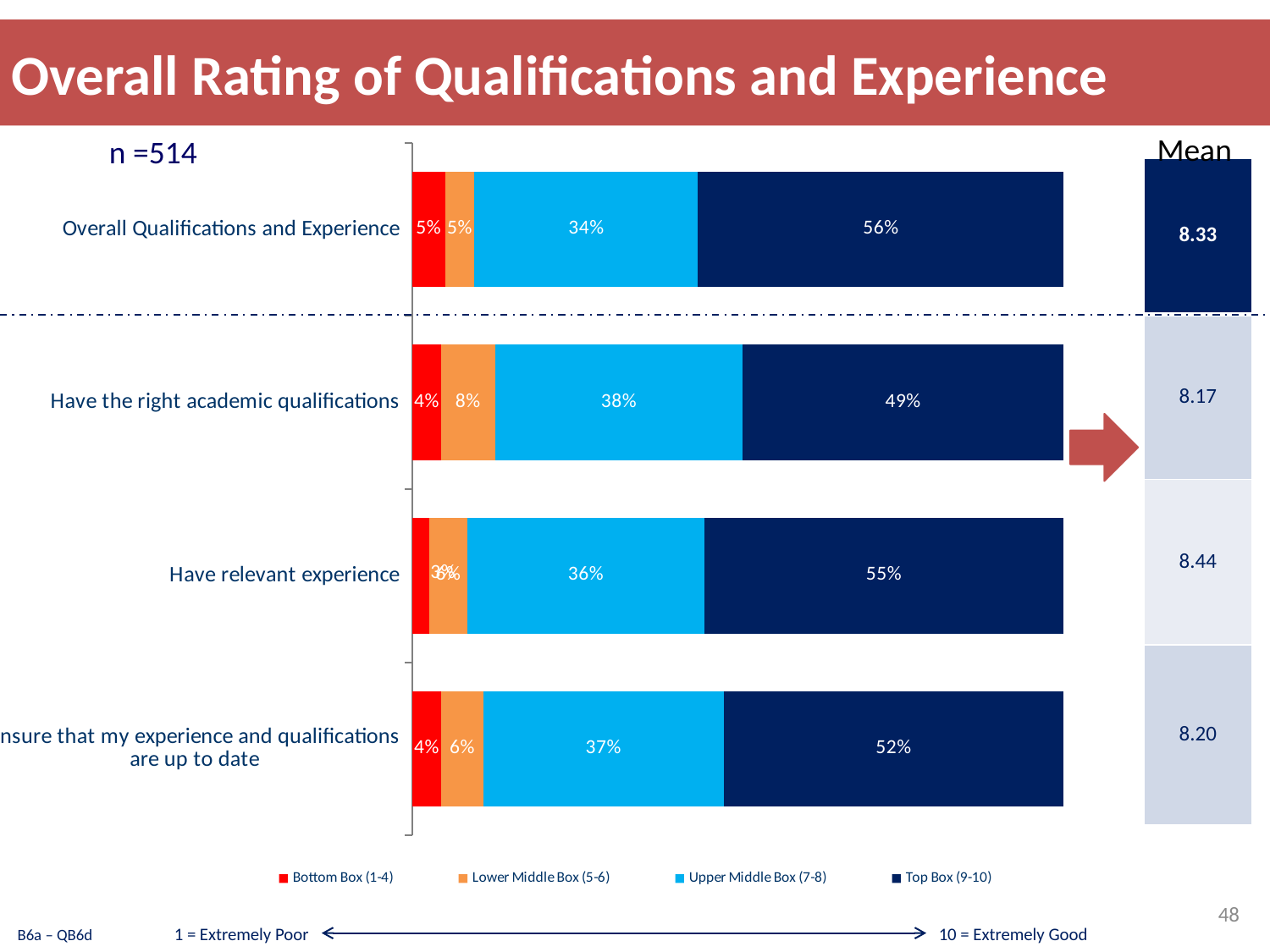
What is the Upper Middle Box (7-8) value for Have the right academic qualifications? 38% What kind of chart is shown on the slide? Stacked bar chart Which category has the lowest Top Box (9-10) value? Have the right academic qualifications Which category has the highest Top Box (9-10) value? Overall Qualifications and Experience What is the Top Box (9-10) value for Have relevant experience? 55% What is the Mean value shown for Have relevant experience? 8.44 How many categories are plotted in the chart? 4 How many series does the legend list? 4 What is the difference between the Top Box (9-10) values for Overall Qualifications and Experience and Have the right academic qualifications? 7 percentage points Which has the larger Upper Middle Box (7-8) value: Have relevant experience or the bottom category about experience and qualifications being up to date? The bottom category (37%) What is the Lower Middle Box (5-6) value for Have the right academic qualifications? 8% What is the Top Box (9-10) value for Overall Qualifications and Experience? 56%